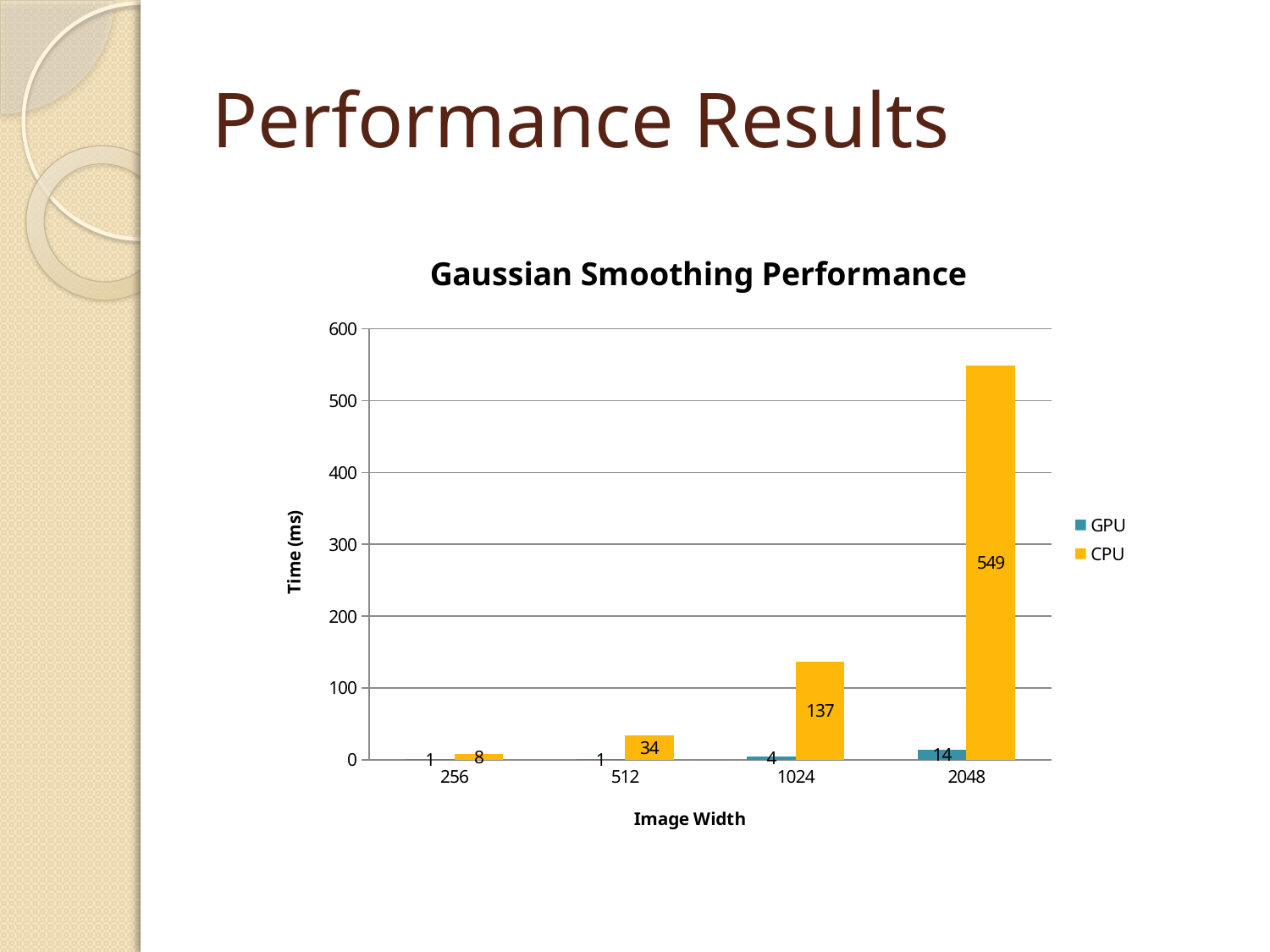
What is the GPU time for image width 2048? 14 What is the difference between the CPU times at image widths 1024 and 512? 103 Which is larger at image width 1024, the CPU time or the GPU time? CPU What kind of chart is shown? Bar chart Which image width has the highest CPU time? 2048 What is the CPU time for image width 512? 34 How many series does the legend list? 2 What is the GPU time for image width 1024? 4 What is the CPU time for image width 2048? 549 How many image width categories are shown on the x axis? 4 Which image width has the lowest CPU time? 256 What is the difference between the CPU and GPU times at image width 2048? 535